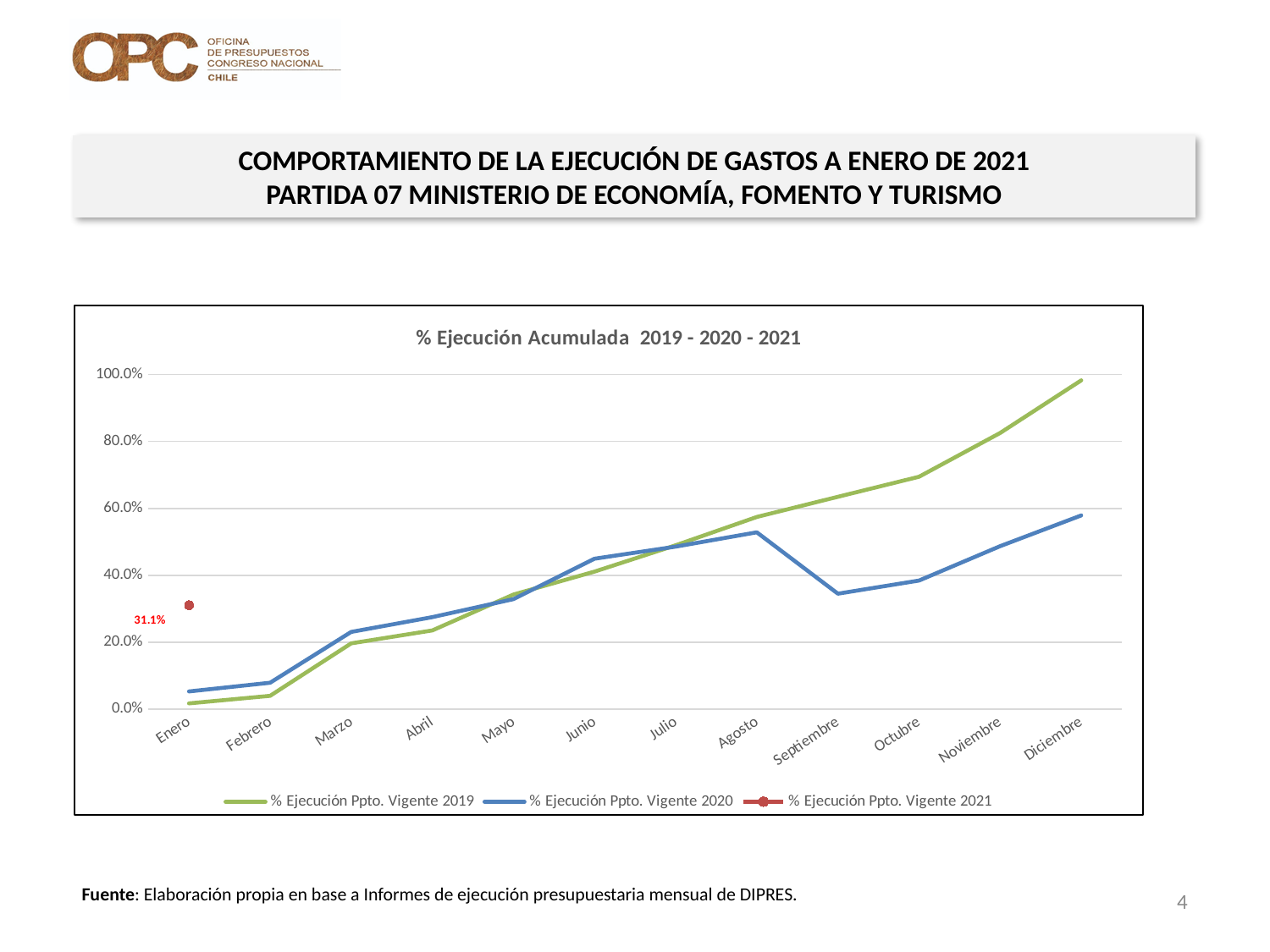
In Enero, which is larger: the value for % Ejecución Ppto. Vigente 2021 or the value for % Ejecución Ppto. Vigente 2020? % Ejecución Ppto. Vigente 2021 Is the value for % Ejecución Ppto. Vigente 2020 in Agosto greater or less than 40.0%? greater Is the value for % Ejecución Ppto. Vigente 2019 in Diciembre greater or less than 80.0%? greater How many months are shown along the x axis? 12 In Diciembre, which series has the higher value: % Ejecución Ppto. Vigente 2019 or % Ejecución Ppto. Vigente 2020? % Ejecución Ppto. Vigente 2019 What kind of chart is shown on the slide? line chart What is the title of the chart? % Ejecución Acumulada 2019 - 2020 - 2021 Is the value for % Ejecución Ppto. Vigente 2020 in Diciembre greater or less than 80.0%? less What is the value of % Ejecución Ppto. Vigente 2021 for Enero? 31.1% How many series does the legend list? 3 In which month does % Ejecución Ppto. Vigente 2019 reach its highest value? Diciembre Does the % Ejecución Ppto. Vigente 2019 line rise or fall from Enero to Diciembre? rise